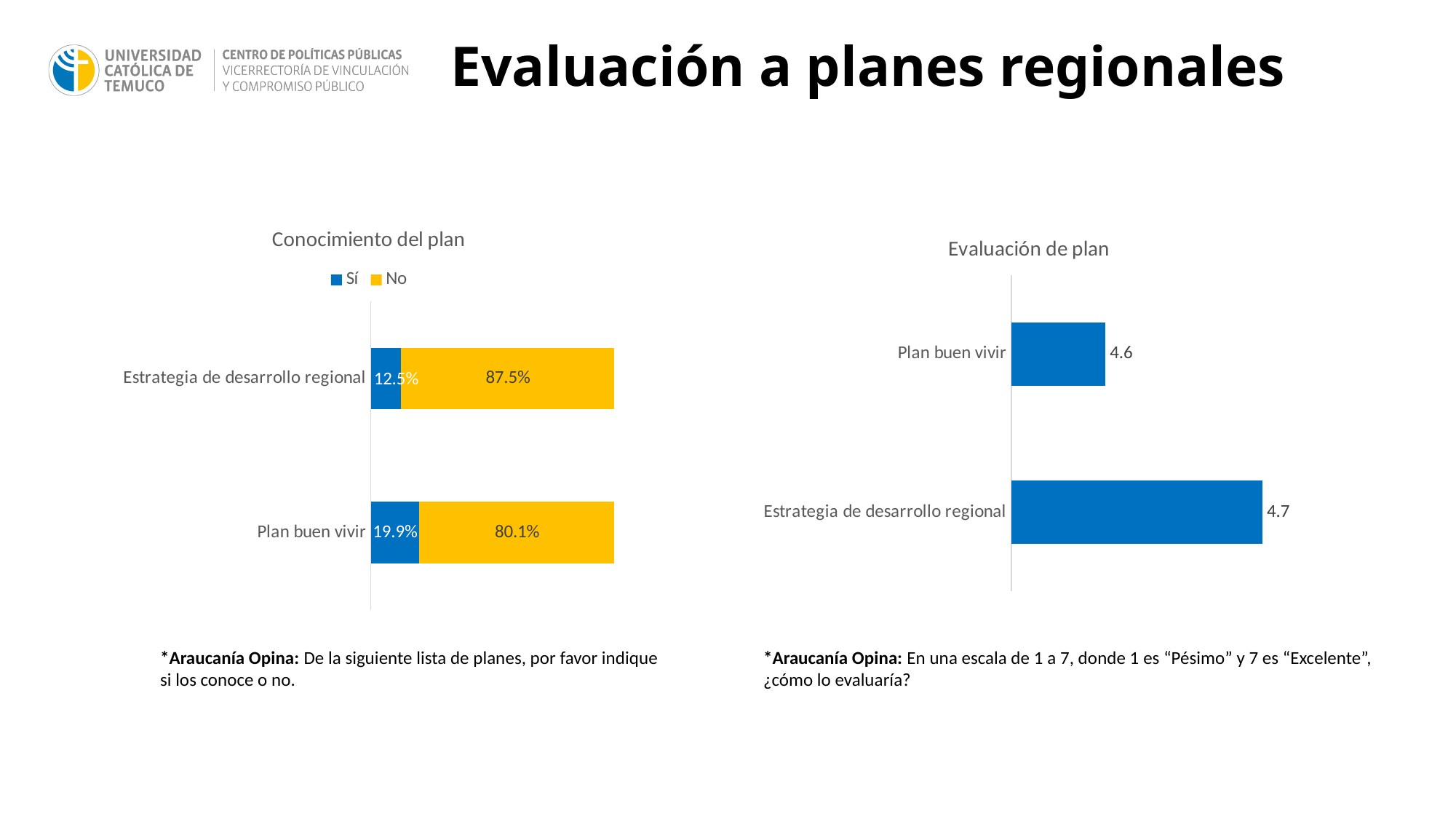
In the 'Evaluación de plan' chart, what is the value for Estrategia de desarrollo regional? 4.7 In the 'Conocimiento del plan' chart, how many series does the legend list? 2 What kind of chart is the 'Evaluación de plan' chart? Bar chart In the 'Conocimiento del plan' chart, what is the total of the stacked bar for Plan buen vivir? 100.0% In the 'Evaluación de plan' chart, which plan has the lowest evaluation? Plan buen vivir In the 'Conocimiento del plan' chart, what is the 'Sí' value for Estrategia de desarrollo regional? 12.5% In the 'Conocimiento del plan' chart, what percentage of respondents said 'Sí' for Plan buen vivir? 19.9% In the 'Conocimiento del plan' chart, what percentage of respondents said 'No' for Estrategia de desarrollo regional? 87.5% In the 'Conocimiento del plan' chart, which plan has the higher 'Sí' percentage? Plan buen vivir In the 'Evaluación de plan' chart, what is the value for Plan buen vivir? 4.6 In the 'Conocimiento del plan' chart, what is the difference between the 'No' values for Estrategia de desarrollo regional and Plan buen vivir? 7.4% In the 'Evaluación de plan' chart, what is the difference between the values for Estrategia de desarrollo regional and Plan buen vivir? 0.1